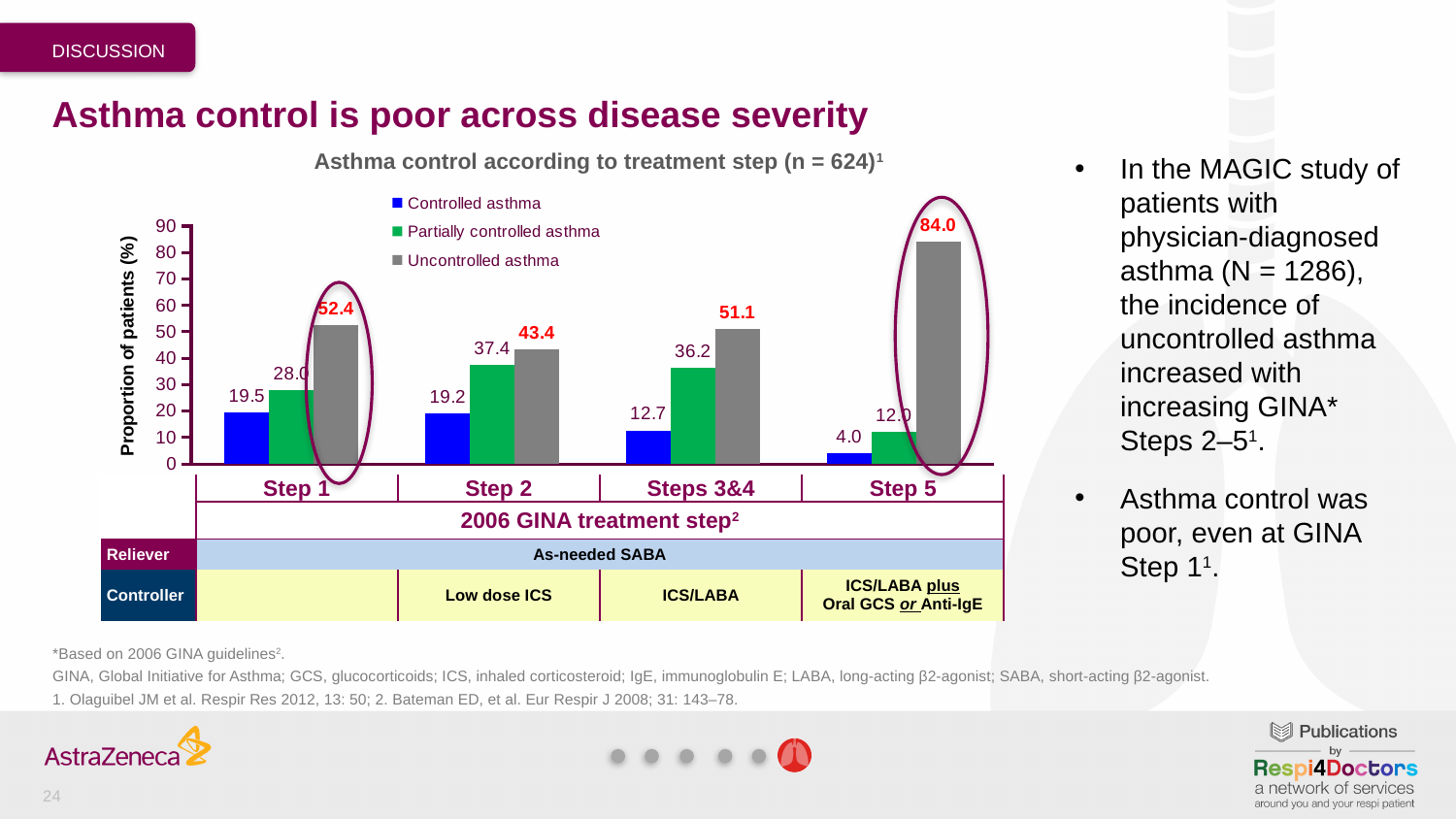
How many series does the legend list? 3 What is the proportion of patients with uncontrolled asthma at Step 5? 84.0 Which treatment step has the highest proportion of uncontrolled asthma? Step 5 What type of chart is shown on the slide? Bar chart Which is larger: the uncontrolled asthma value at Step 2 or at Steps 3&4? Steps 3&4 What is the difference between the uncontrolled asthma values at Step 5 and Step 1? 31.6 What is the proportion of patients with controlled asthma at Step 1? 19.5 What is the title of the chart? Asthma control according to treatment step (n = 624) What is the proportion of patients with partially controlled asthma at Step 2? 37.4 How many treatment step categories are shown on the x axis? 4 Which treatment step has the lowest proportion of controlled asthma? Step 5 Does the proportion of controlled asthma fall or rise across the treatment steps from Step 1 to Step 5? Fall